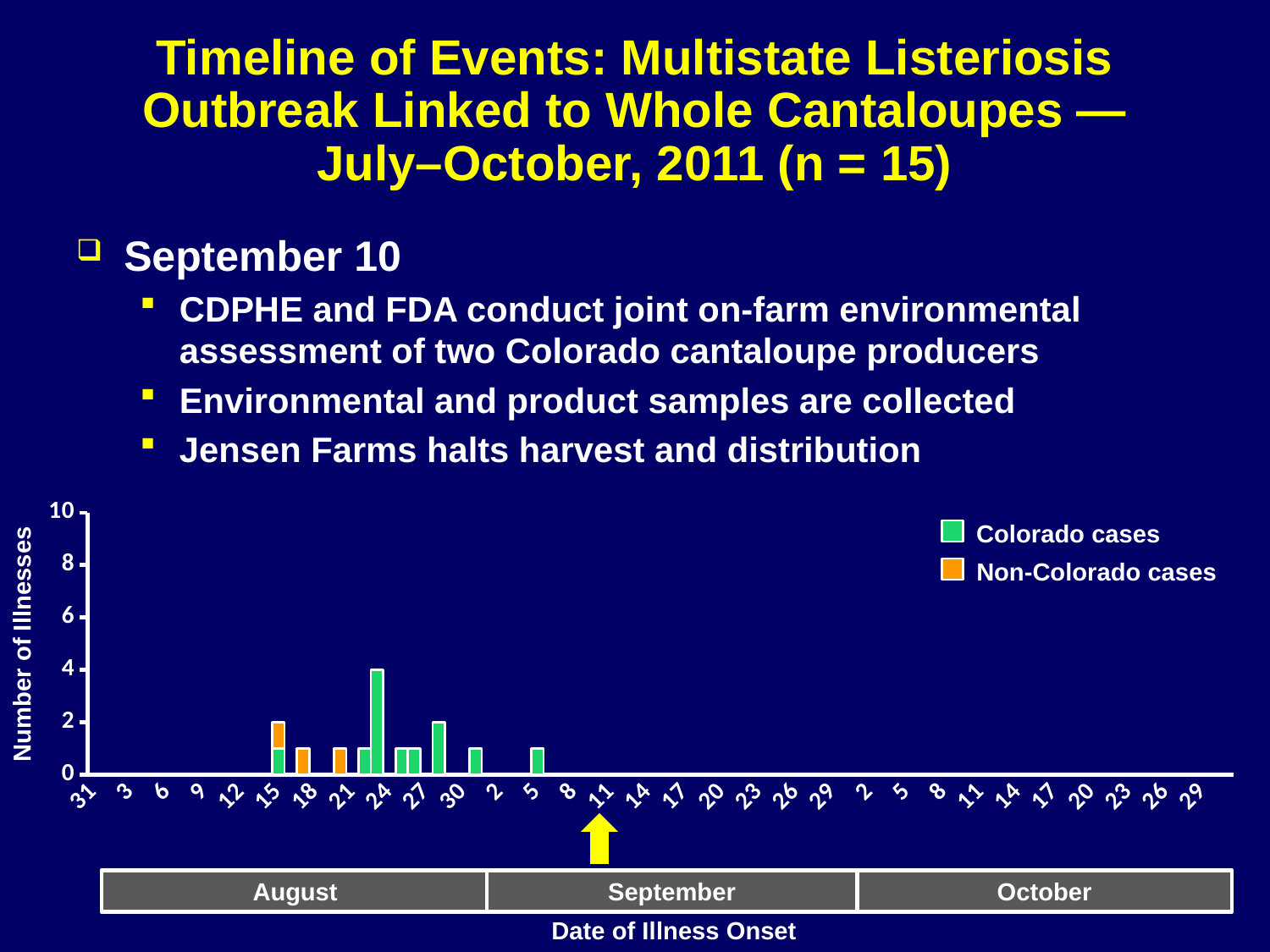
How many illnesses are shown for the August 28 onset date? 2 How many months are labeled along the x axis of the chart? 3 Is the number of illnesses for August 23 greater or less than 6? less What is the total height of the stacked bar for August 15? 2 How many series does the chart legend list? 2 What are the two series named in the chart legend? Colorado cases and Non-Colorado cases What is the label of the vertical axis of the chart? Number of Illnesses On which date of illness onset does the tallest bar occur? August 23 How many illnesses are shown for the August 23 onset date? 4 Which onset date has more illnesses, August 23 or September 5? August 23 What is the difference between the number of illnesses on August 23 and on August 28? 2 What type of chart is shown at the bottom of the slide? bar chart